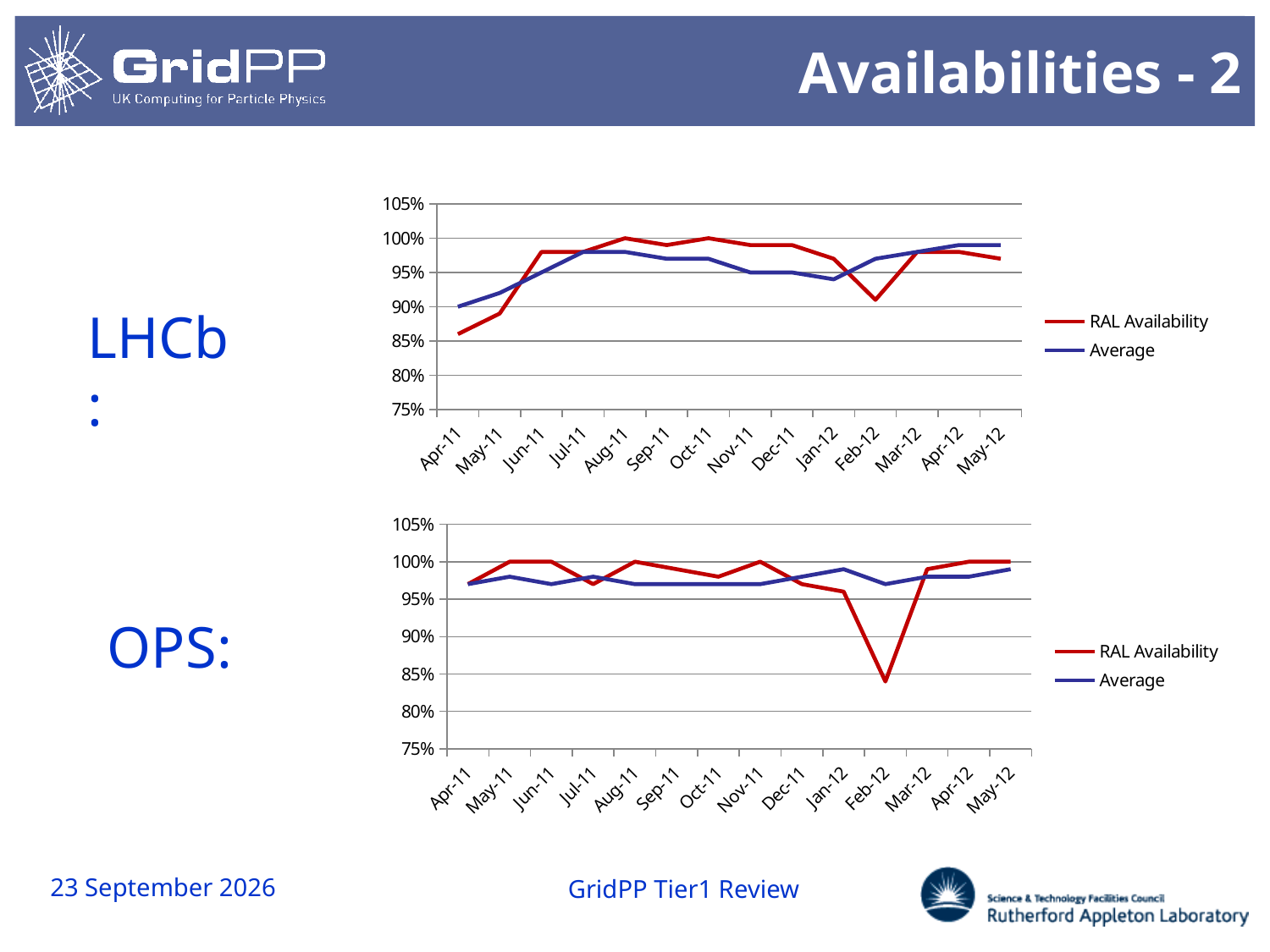
What are the two legend entries in the LHCb chart (top chart)? RAL Availability and Average In the OPS chart (bottom chart), is the RAL Availability value for Feb-12 greater or less than 90%? less What kind of chart is the LHCb chart (top chart)? line chart In the LHCb chart (top chart), which series is higher in Feb-12, RAL Availability or Average? Average In the OPS chart (bottom chart), what is the RAL Availability value for May-11? 100% How many series does the legend of the OPS chart (bottom chart) list? 2 In the LHCb chart (top chart), does the RAL Availability line rise or fall from Apr-11 to Jun-11? rise In the OPS chart (bottom chart), which series is higher in Feb-12, RAL Availability or Average? Average In the LHCb chart (top chart), is the RAL Availability value for Apr-11 greater or less than 90%? less In the LHCb chart (top chart), which month has the lowest RAL Availability? Apr-11 How many months are shown on the x axis of the LHCb chart (top chart)? 14 In the OPS chart (bottom chart), which month has the lowest RAL Availability? Feb-12